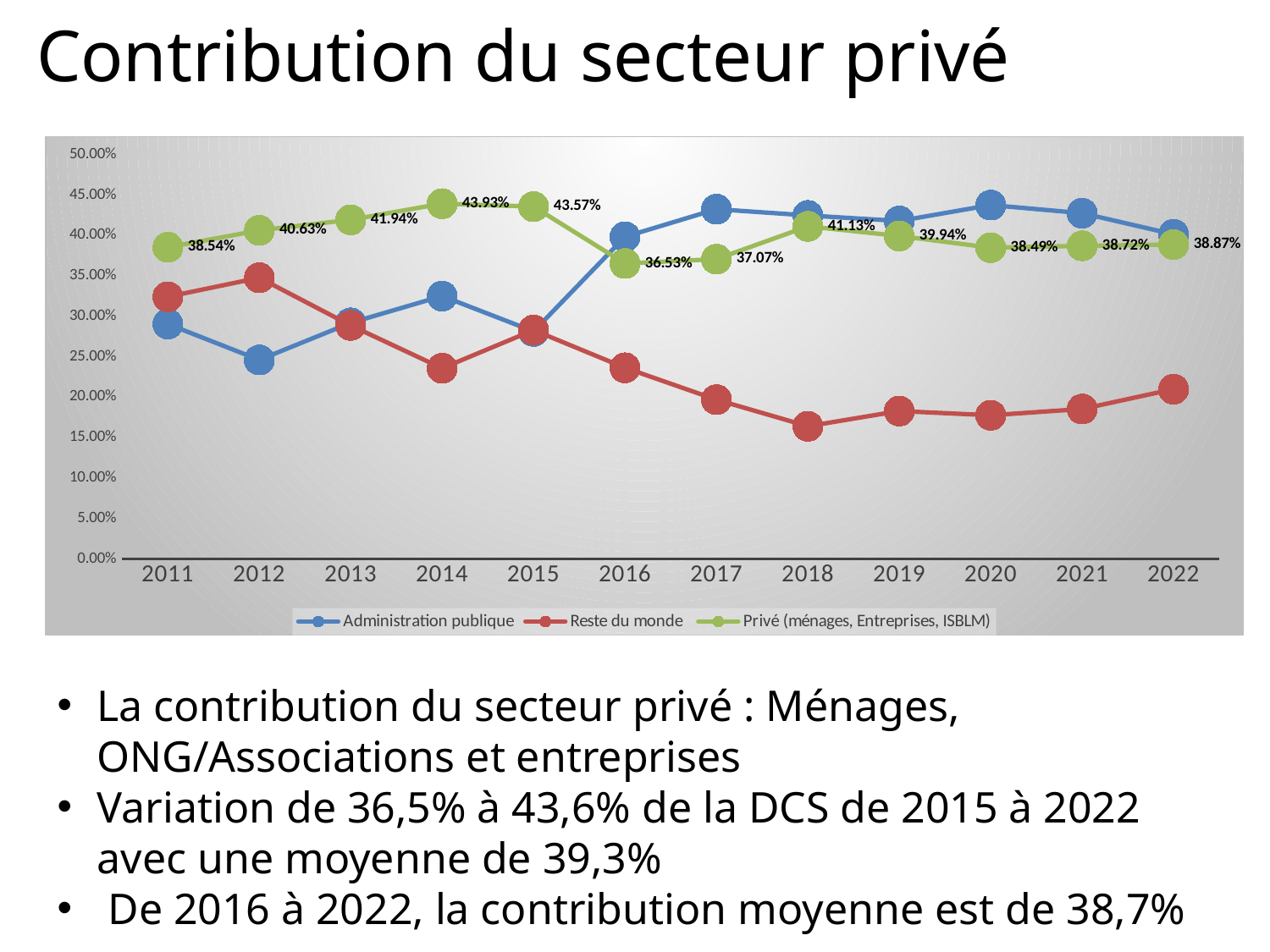
What is the difference between the Privé (ménages, Entreprises, ISBLM) values for 2014 and 2016? 7.40% In which year is the Privé (ménages, Entreprises, ISBLM) series at its highest? 2014 How many series does the legend list? 3 In which year is the Privé (ménages, Entreprises, ISBLM) series at its lowest? 2016 Which is larger for Privé (ménages, Entreprises, ISBLM): the value in 2013 or the value in 2019? 2013 What is the value for Privé (ménages, Entreprises, ISBLM) in 2014? 43.93% Is the value for Reste du monde in 2018 greater or less than 20.00%? less What is the value for Privé (ménages, Entreprises, ISBLM) in 2022? 38.87% What is the value for Privé (ménages, Entreprises, ISBLM) in 2016? 36.53% How many years are shown on the x axis? 12 Is the value for Administration publique in 2020 greater or less than 40.00%? greater What kind of chart is shown on the slide? Line chart